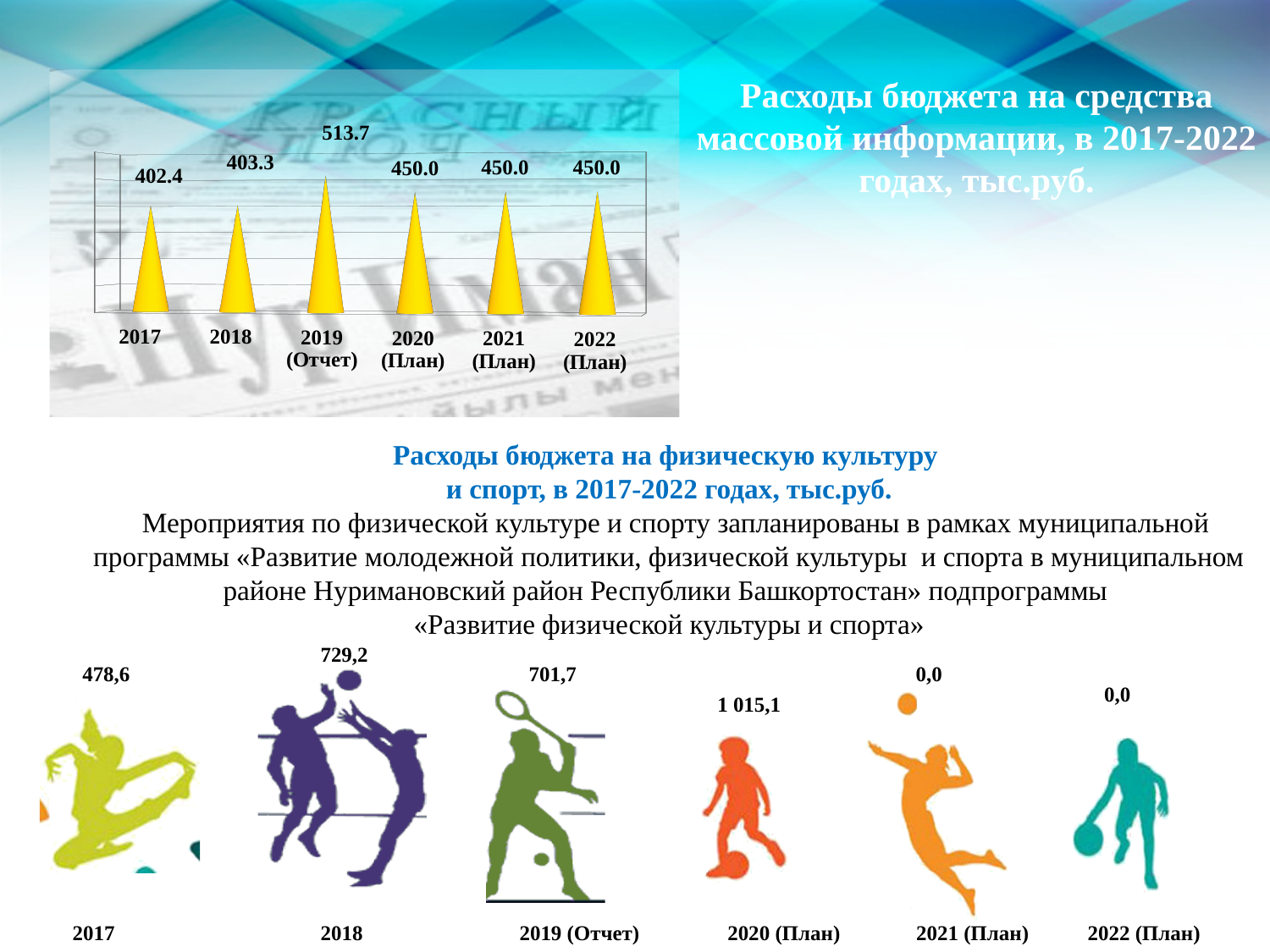
In the chart 'Расходы бюджета на средства массовой информации', which is larger, the value for 2018 or the value for 2020 (План)? 2020 (План) In what units are the values in the chart 'Расходы бюджета на средства массовой информации' given, according to its title? тыс.руб. What kind of chart is 'Расходы бюджета на средства массовой информации'? bar chart In the chart 'Расходы бюджета на средства массовой информации', what is the value for 2021 (План)? 450.0 In the chart 'Расходы бюджета на средства массовой информации', what is the value for 2017? 402.4 In the chart 'Расходы бюджета на средства массовой информации', which year has the highest value? 2019 (Отчет) How many years are shown in the chart 'Расходы бюджета на средства массовой информации'? 6 In the chart 'Расходы бюджета на средства массовой информации', do the values rise or fall from 2017 to 2019 (Отчет)? rise In the chart 'Расходы бюджета на средства массовой информации', which year has the lowest value? 2017 In the chart 'Расходы бюджета на средства массовой информации', what is the difference between the values for 2019 (Отчет) and 2020 (План)? 63.7 In the chart 'Расходы бюджета на средства массовой информации', what is the difference between the values for 2019 (Отчет) and 2017? 111.3 In the chart 'Расходы бюджета на средства массовой информации', what is the value for 2019 (Отчет)? 513.7